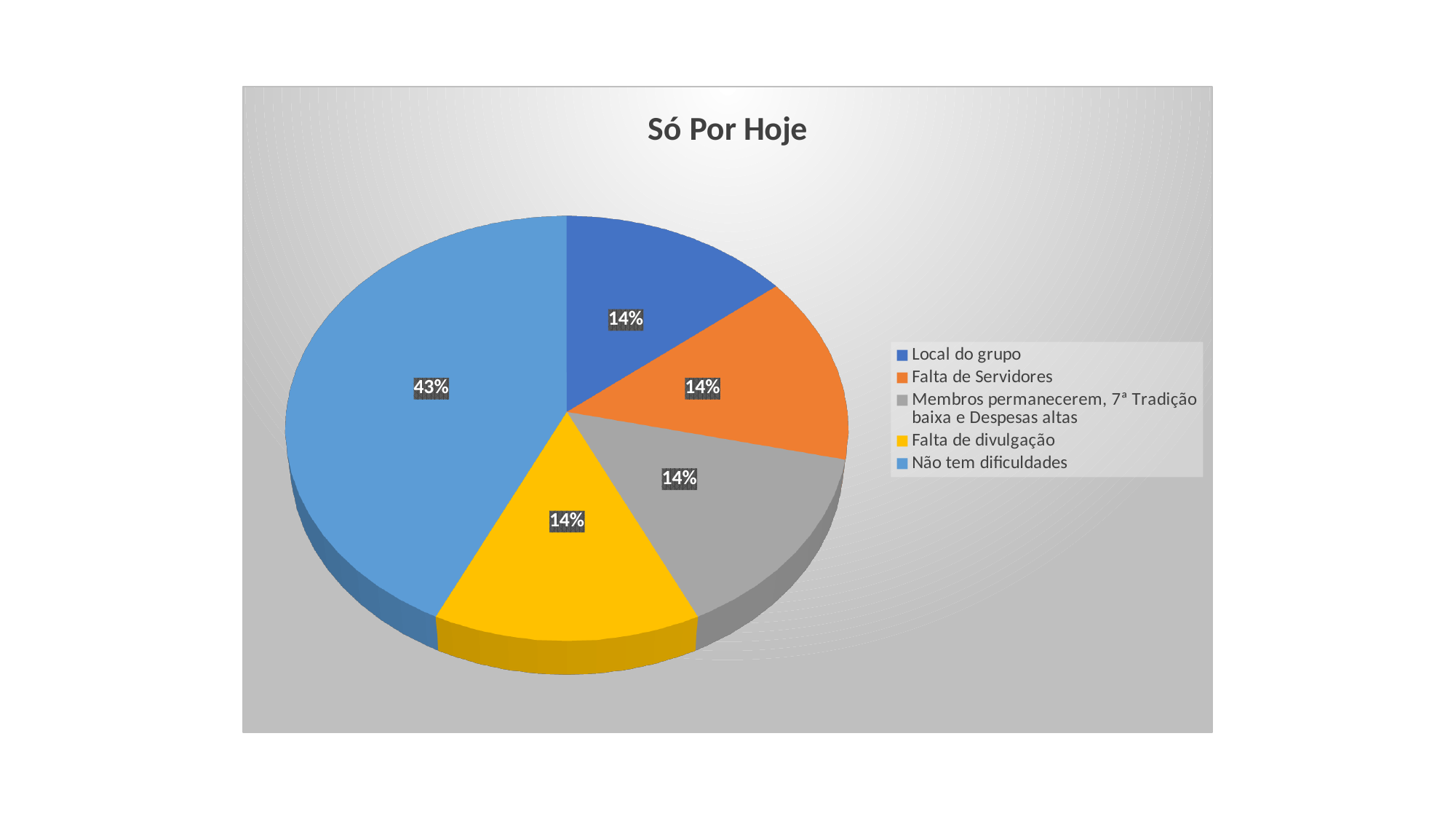
Which colour represents 'Falta de divulgação' in the chart? yellow How many entries does the legend list? 5 Which category has the largest slice of the pie? Não tem dificuldades What share of the pie does 'Falta de Servidores' represent? 14% What is the title of the chart? Só Por Hoje What is the difference between the share for 'Não tem dificuldades' and the share for 'Falta de Servidores'? 29% What share of the pie does 'Falta de divulgação' represent? 14% Which is larger: the share for 'Não tem dificuldades' or the share for 'Local do grupo'? Não tem dificuldades What share of the pie does 'Não tem dificuldades' represent? 43% What kind of chart is shown on the slide? pie chart How many slices does the pie chart have? 5